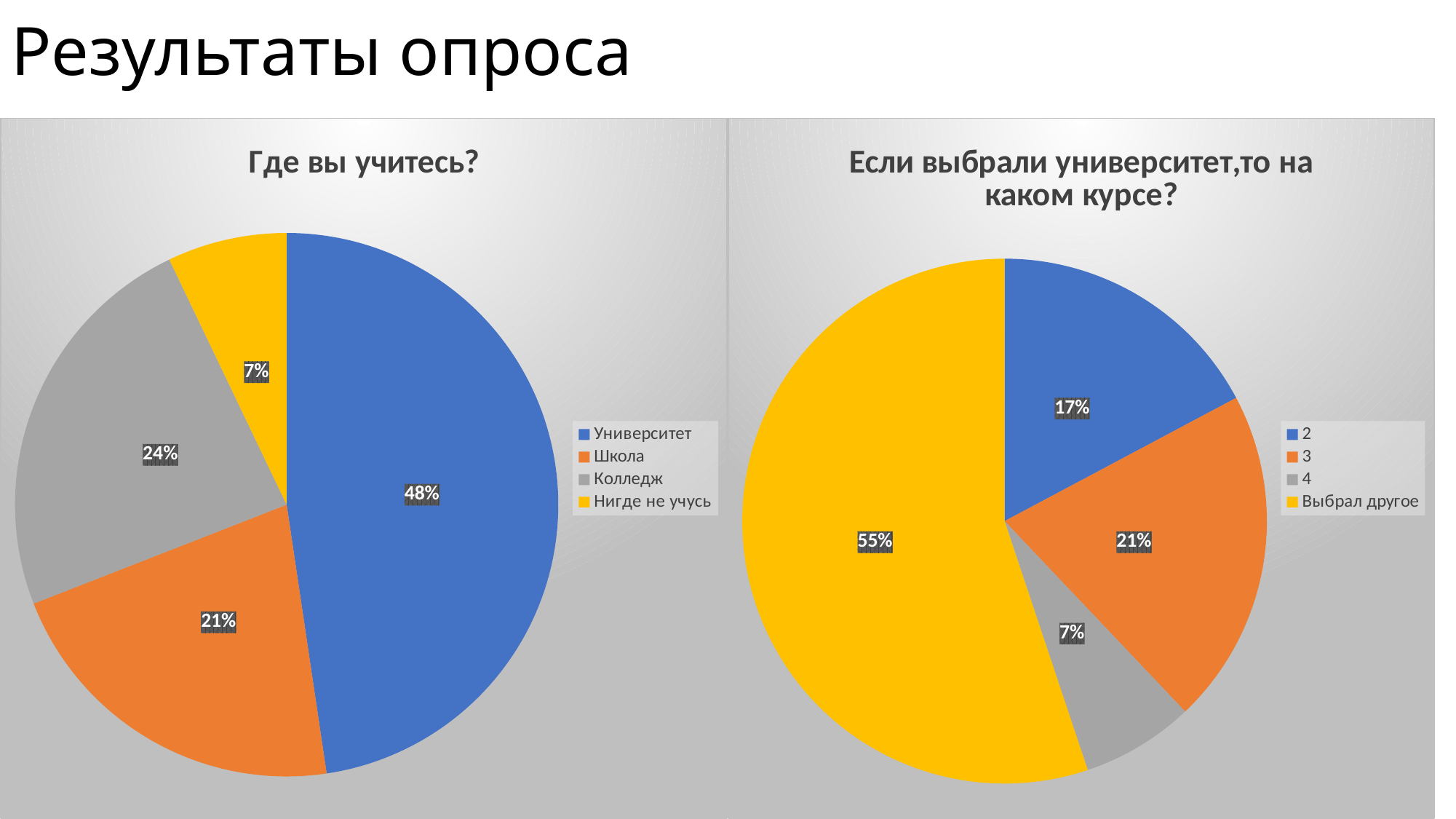
In the chart titled "Если выбрали университет,то на каком курсе?", what percentage is shown for Выбрал другое? 55% In the chart titled "Где вы учитесь?", what is the difference in percentage points between Университет and Школа? 27 In the chart titled "Если выбрали университет,то на каком курсе?", which category has the smallest share? 4 In the chart titled "Где вы учитесь?", which category has the largest share? Университет What type of chart is the chart titled "Где вы учитесь?"? Pie chart In the chart titled "Если выбрали университет,то на каком курсе?", what colour is the slice for Выбрал другое? Yellow In the chart titled "Если выбрали университет,то на каком курсе?", which is larger: the share for course 3 or the share for course 2? 3 In the chart titled "Где вы учитесь?", how many categories does the pie show? 4 In the chart titled "Если выбрали университет,то на каком курсе?", what percentage is shown for course 2? 17% In the chart titled "Где вы учитесь?", what percentage is shown for Университет? 48% In the chart titled "Где вы учитесь?", what percentage is shown for Колледж? 24% In the chart titled "Где вы учитесь?", which category has the smallest share? Нигде не учусь